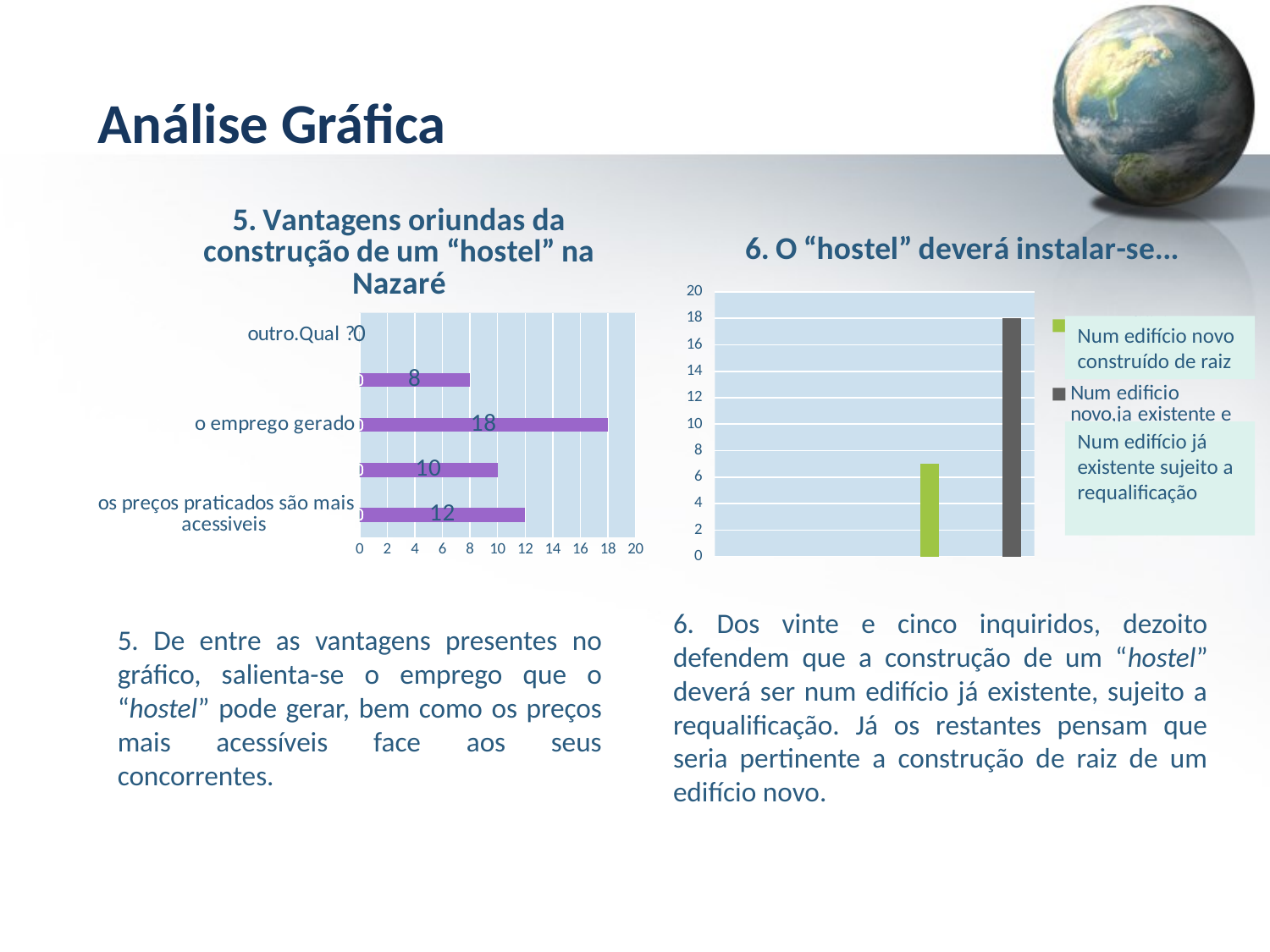
In the chart "5. Vantagens oriundas da construção de um "hostel" na Nazaré", which category has the lowest value? outro.Qual ? In the chart "6. O "hostel" deverá instalar-se...", is the value for "Num edifício novo construído de raiz" greater or less than 10? less How many bars are plotted in the chart "5. Vantagens oriundas da construção de um "hostel" na Nazaré"? 4 In the chart "5. Vantagens oriundas da construção de um "hostel" na Nazaré", what is the value for "outro.Qual ?"? 0 In the chart "5. Vantagens oriundas da construção de um "hostel" na Nazaré", what is the value for "os preços praticados são mais acessiveis"? 12 In the chart "6. O "hostel" deverá instalar-se...", what value does the taller (gray) bar reach? 18 In the chart "5. Vantagens oriundas da construção de um "hostel" na Nazaré", what is the difference between the values for "o emprego gerado" and "os preços praticados são mais acessiveis"? 6 What kind of chart is "6. O "hostel" deverá instalar-se..."? Bar chart What kind of chart is "5. Vantagens oriundas da construção de um "hostel" na Nazaré"? Bar chart How many bars are plotted in the chart "6. O "hostel" deverá instalar-se..."? 2 In the chart "5. Vantagens oriundas da construção de um "hostel" na Nazaré", which category has the highest value? o emprego gerado In the chart "5. Vantagens oriundas da construção de um "hostel" na Nazaré", what is the value for "o emprego gerado"? 18